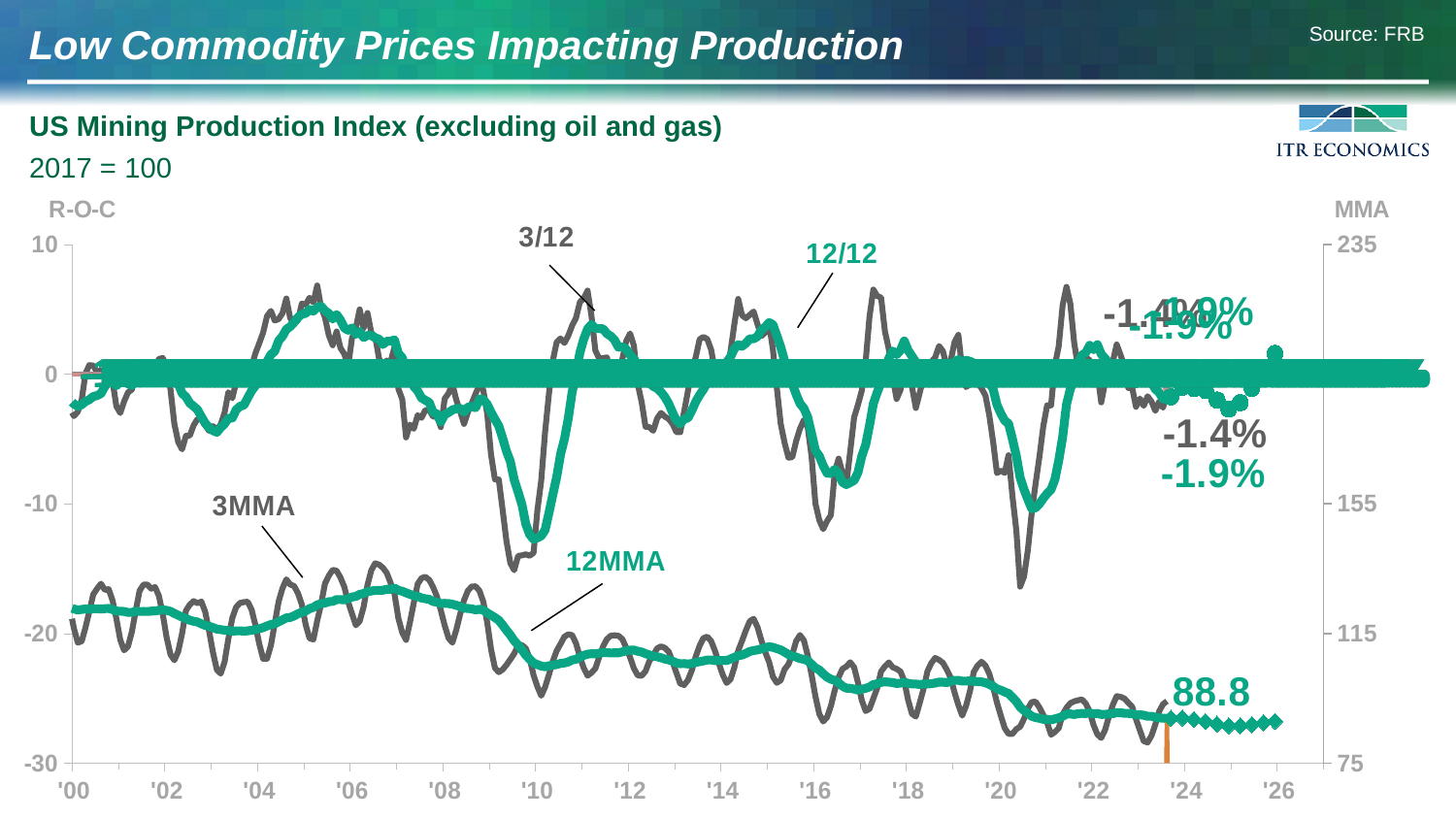
What is the latest labeled value of the 3/12 rate-of-change line? -1.4% What is the difference between the latest 3/12 value (-1.4%) and the latest 12/12 value (-1.9%)? 0.5 percentage points What is the title of the chart? US Mining Production Index (excluding oil and gas) Which is lower, the latest 3/12 value or the latest 12/12 value? 12/12 Is the latest 12MMA value greater or less than 115 on the right axis? less Is the 12MMA value around '06 greater or less than 115 on the right axis? greater What label is shown above the left vertical axis? R-O-C What is the latest labeled value of the 12/12 rate-of-change line? -1.9% What kind of chart is shown on the slide? line chart What is the latest labeled value of the 12MMA line? 88.8 Does the 12MMA line generally rise or fall from '00 to '24? fall